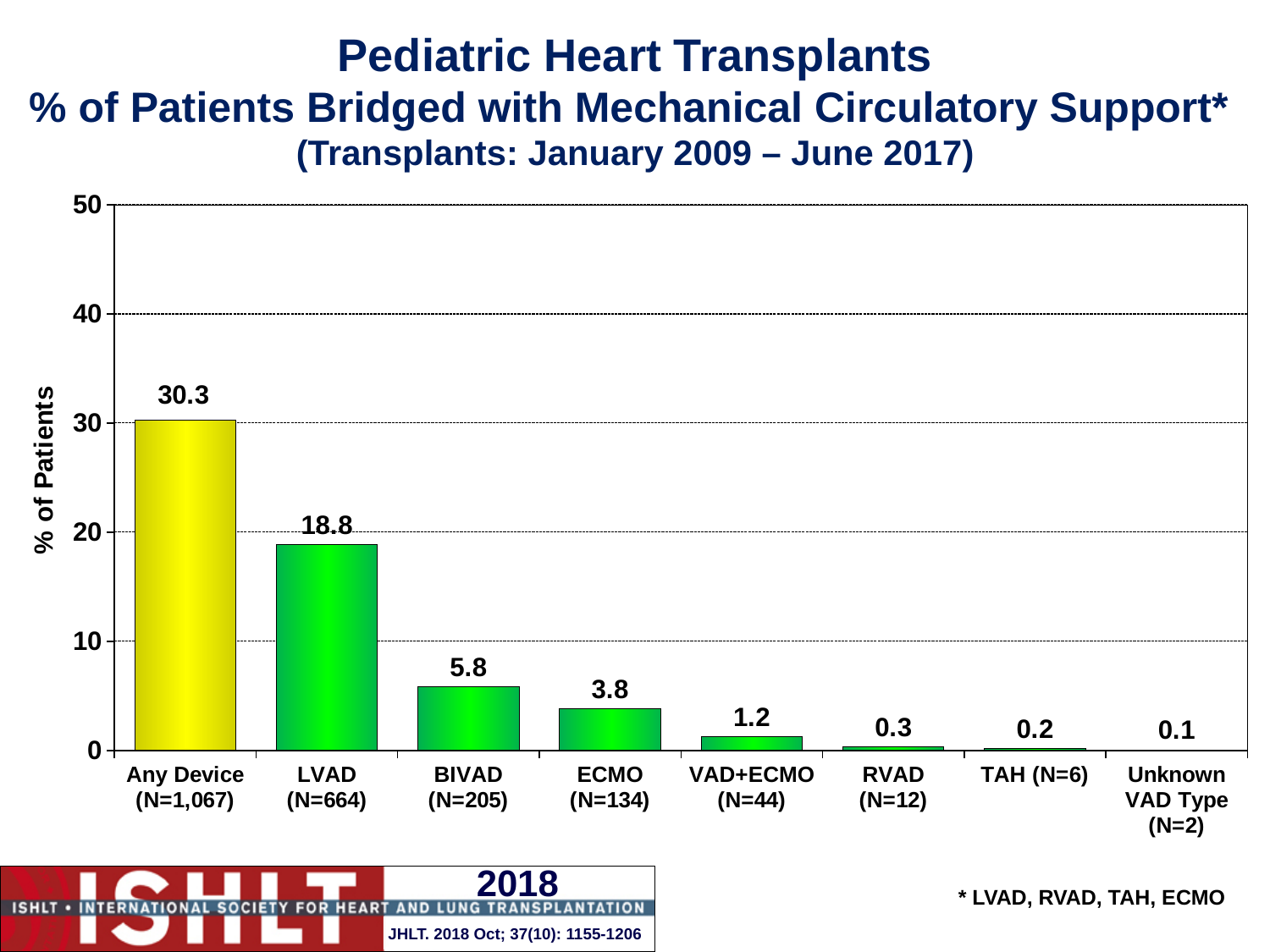
Which category has the highest value? Any Device (N=1,067) What is the value for VAD+ECMO (N=44)? 1.2 What is the value for ECMO (N=134)? 3.8 Is the value for Any Device (N=1,067) greater or less than 20? greater What is the label of the y axis? % of Patients Which is larger, the value for BIVAD (N=205) or the value for RVAD (N=12)? BIVAD (N=205) How many categories are shown on the x axis? 8 What kind of chart is shown on the slide? bar chart What is the value for LVAD (N=664)? 18.8 Which category has the lowest value? Unknown VAD Type (N=2) What is the difference between the values for BIVAD (N=205) and ECMO (N=134)? 2.0 What is the difference between the values for Any Device (N=1,067) and LVAD (N=664)? 11.5